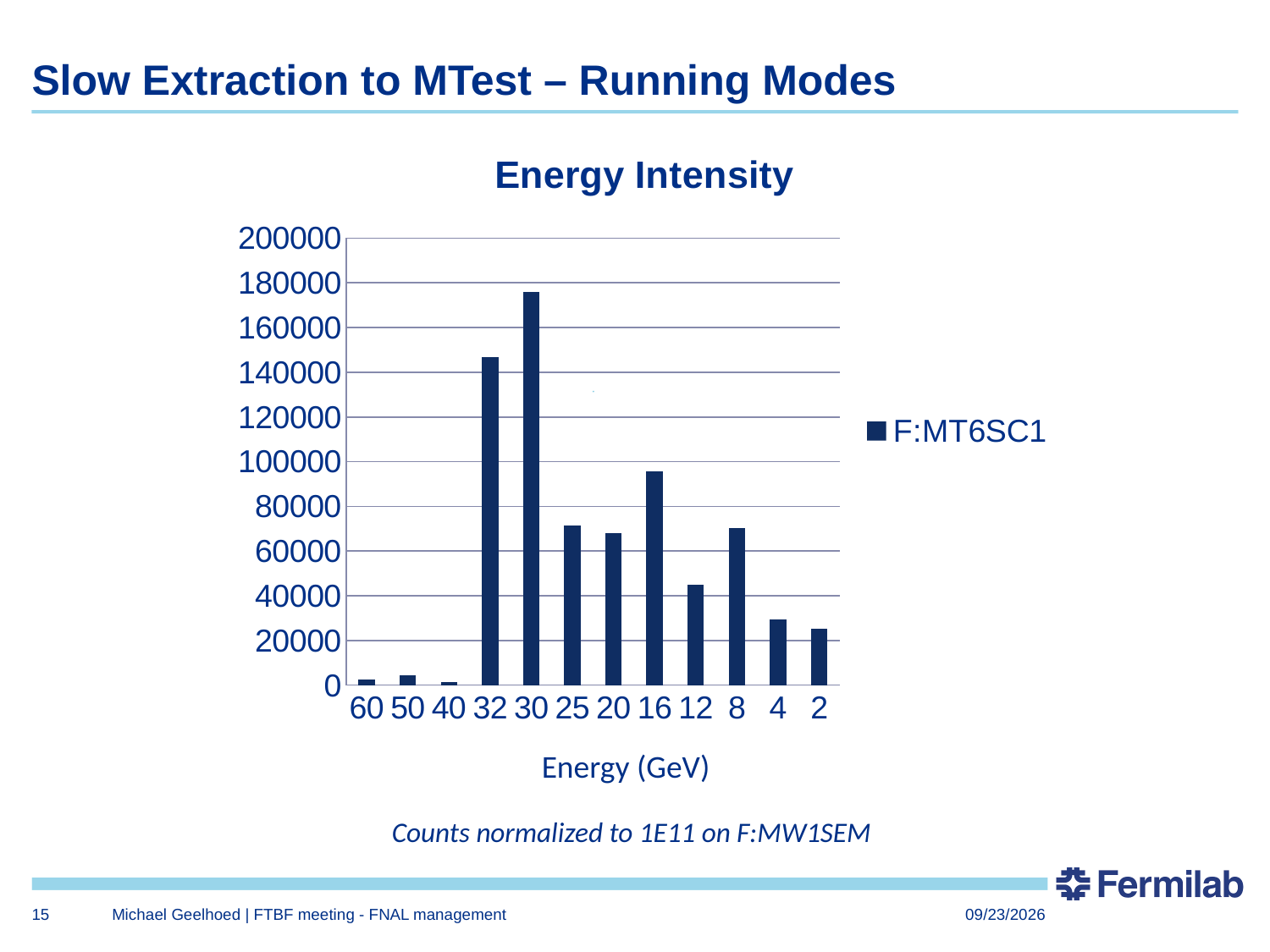
What is the name of the series shown in the legend? F:MT6SC1 How many energy categories are shown on the x axis? 12 Which has a larger value, 12 GeV or 4 GeV? 12 What is the title of the chart? Energy Intensity How many series does the legend list? 1 Which has a larger value, 32 GeV or 16 GeV? 32 Is the value for 4 GeV greater or less than 20000? greater Is the value for 30 GeV greater or less than 160000? greater Is the value for 32 GeV greater or less than 140000? greater What type of chart is shown on the slide? bar chart Which energy (GeV) has the highest value? 30